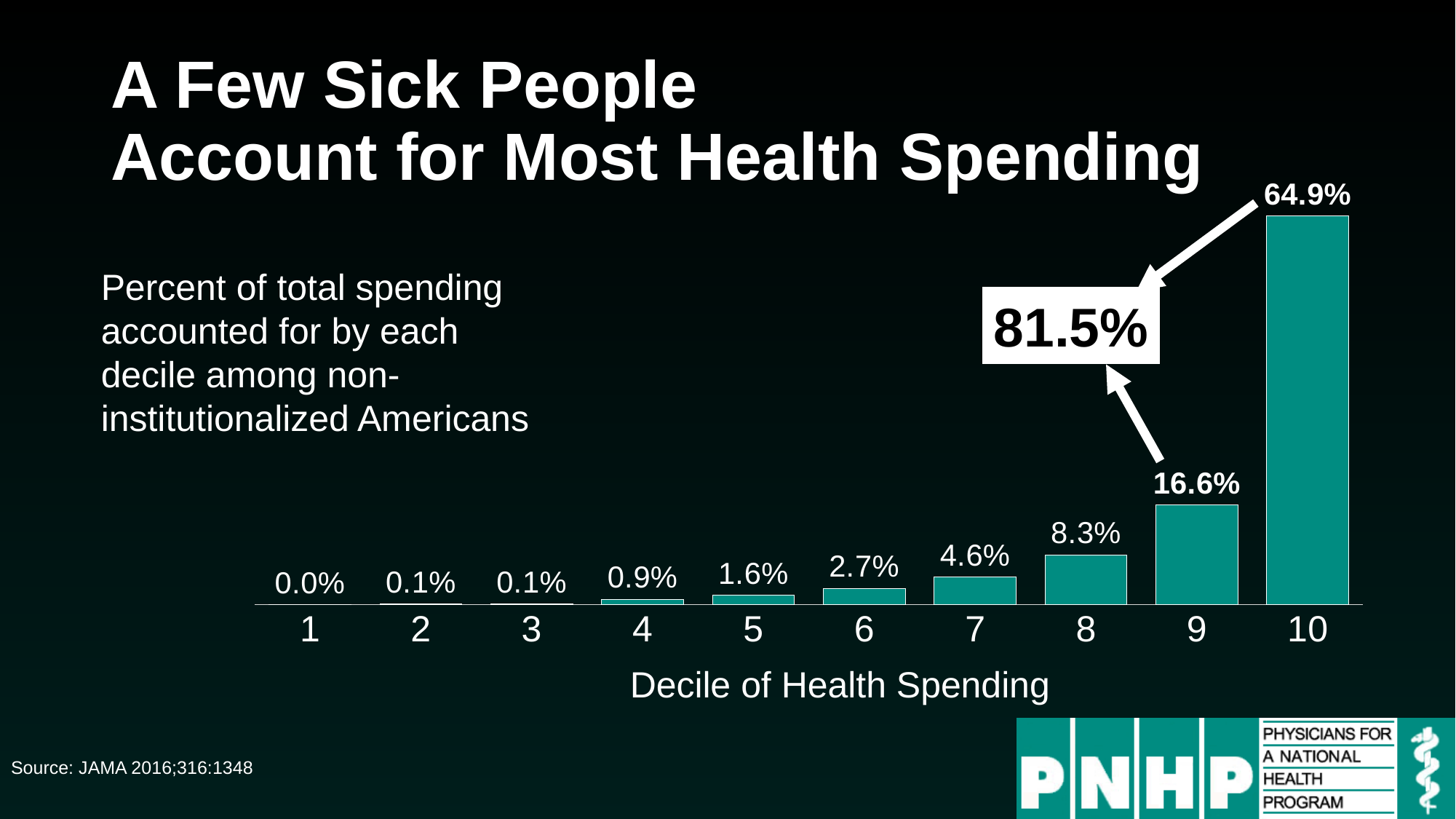
Which decile accounts for the highest share of total spending? 10 What is the value shown for decile 4? 0.9% What is the value shown for decile 7? 4.6% Which decile accounts for the lowest share of total spending? 1 What is the difference between the values for decile 8 and decile 7? 3.7% What combined percentage is shown in the callout box for deciles 9 and 10? 81.5% What percent of total spending is accounted for by decile 9? 16.6% How many deciles are shown on the x axis? 10 Which has a larger value, decile 6 or decile 8? decile 8 What percent of total spending is accounted for by decile 10? 64.9% What is the difference between the values for decile 10 and decile 9? 48.3% What kind of chart is shown on the slide? bar chart